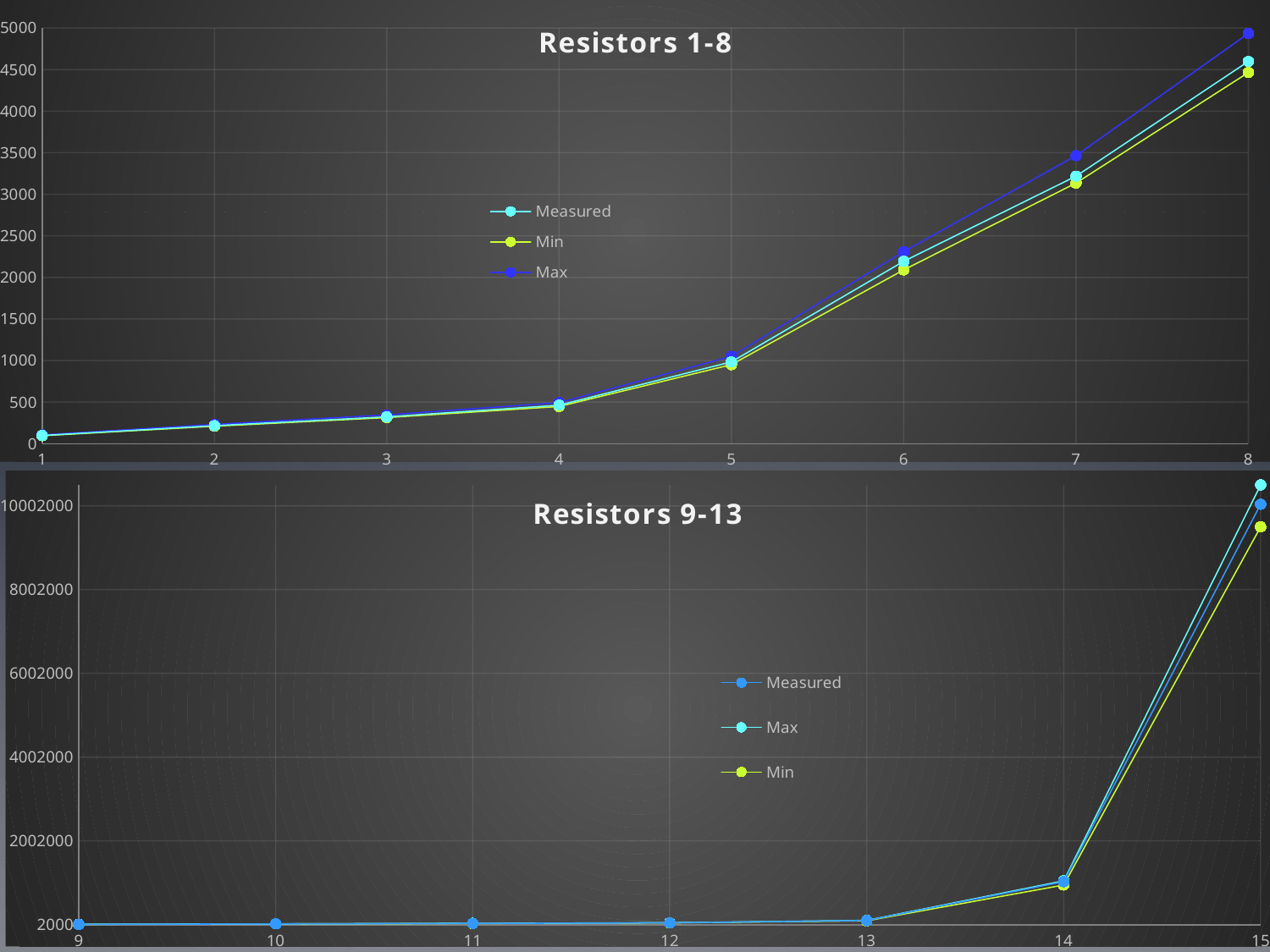
How many series does the legend of the 'Resistors 1-8' chart list? 3 In the 'Resistors 1-8' chart, which is larger at resistor 8: the Max value or the Min value? Max In the 'Resistors 1-8' chart, do the Measured values rise or fall from resistor 1 to resistor 8? rise How many series does the legend of the 'Resistors 9-13' chart list? 3 In the 'Resistors 1-8' chart, which resistor has the highest Max value? 8 In the 'Resistors 9-13' chart, is the Measured value at 14 greater or less than 2002000? less What is the title of the bottom chart? Resistors 9-13 In the 'Resistors 1-8' chart, is the Max value for resistor 8 greater or less than 4500? greater In the 'Resistors 9-13' chart, which x-axis value has the highest Measured value? 15 In the 'Resistors 1-8' chart, is the Measured value for resistor 6 greater or less than 2000? greater What type of chart is the 'Resistors 1-8' chart? line chart How many points are plotted along the x axis of the 'Resistors 1-8' chart? 8